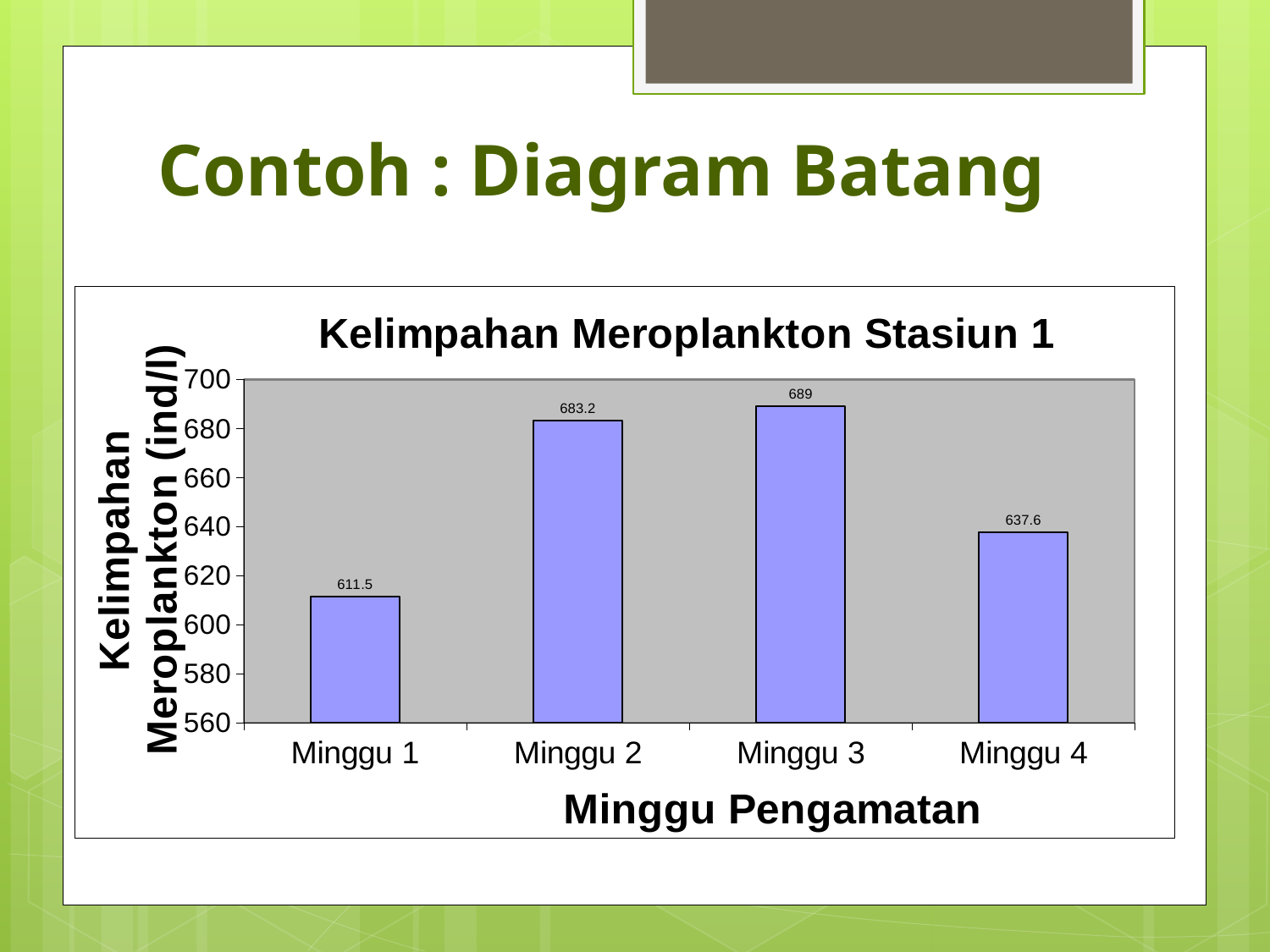
Which week has the highest value? Minggu 3 What is the value for Minggu 2? 683.2 What is the value for Minggu 1? 611.5 How many weeks (categories) are shown on the x axis? 4 Which is larger, the value for Minggu 4 or the value for Minggu 1? Minggu 4 What is the difference between the values for Minggu 2 and Minggu 1? 71.7 What is the title of the chart? Kelimpahan Meroplankton Stasiun 1 What is the value for Minggu 3? 689 What is the difference between the values for Minggu 3 and Minggu 4? 51.4 Which week has the lowest value? Minggu 1 What is the value for Minggu 4? 637.6 Is the value for Minggu 2 greater or less than 660? greater